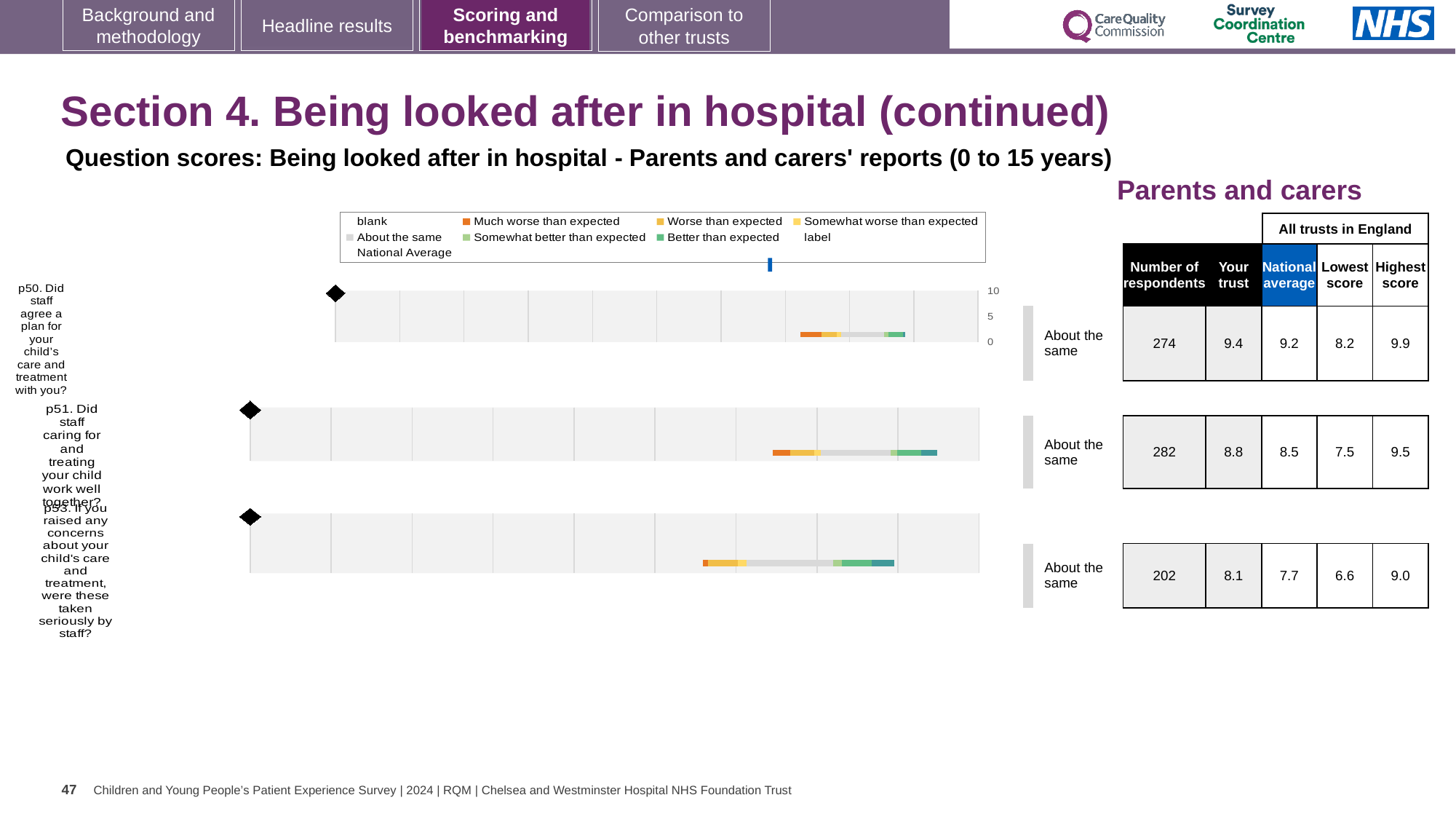
Which legend entry is shown in orange on the benchmarking charts? Much worse than expected In the table beside the charts, what is the number of respondents for p53 (If you raised any concerns about your child's care and treatment, were these taken seriously by staff?)? 202 In the table beside the charts, what is the 'Your trust' score for p50 (Did staff agree a plan for your child's care and treatment with you?)? 9.4 Which of the three questions has the highest 'Your trust' score in the table beside the charts? p50 What is the highest tick value shown on the score axis of the p50 chart? 10 What is the difference between the 'Your trust' score and the national average for p53 in the table beside the charts? 0.4 How many survey questions (p50, p51, p53) have a benchmarking bar chart on this slide? 3 Is the 'Your trust' score for p51 larger or smaller than the national average for p51 in the table beside the charts? larger In the table beside the charts, what is the national average for p51 (Did staff caring for and treating your child work well together?)? 8.5 What benchmark category is shown next to each of the three charts? About the same What kind of chart is used to show the question scores on this slide? bar chart Which of the three questions has the lowest 'Lowest score' value in the table beside the charts? p53